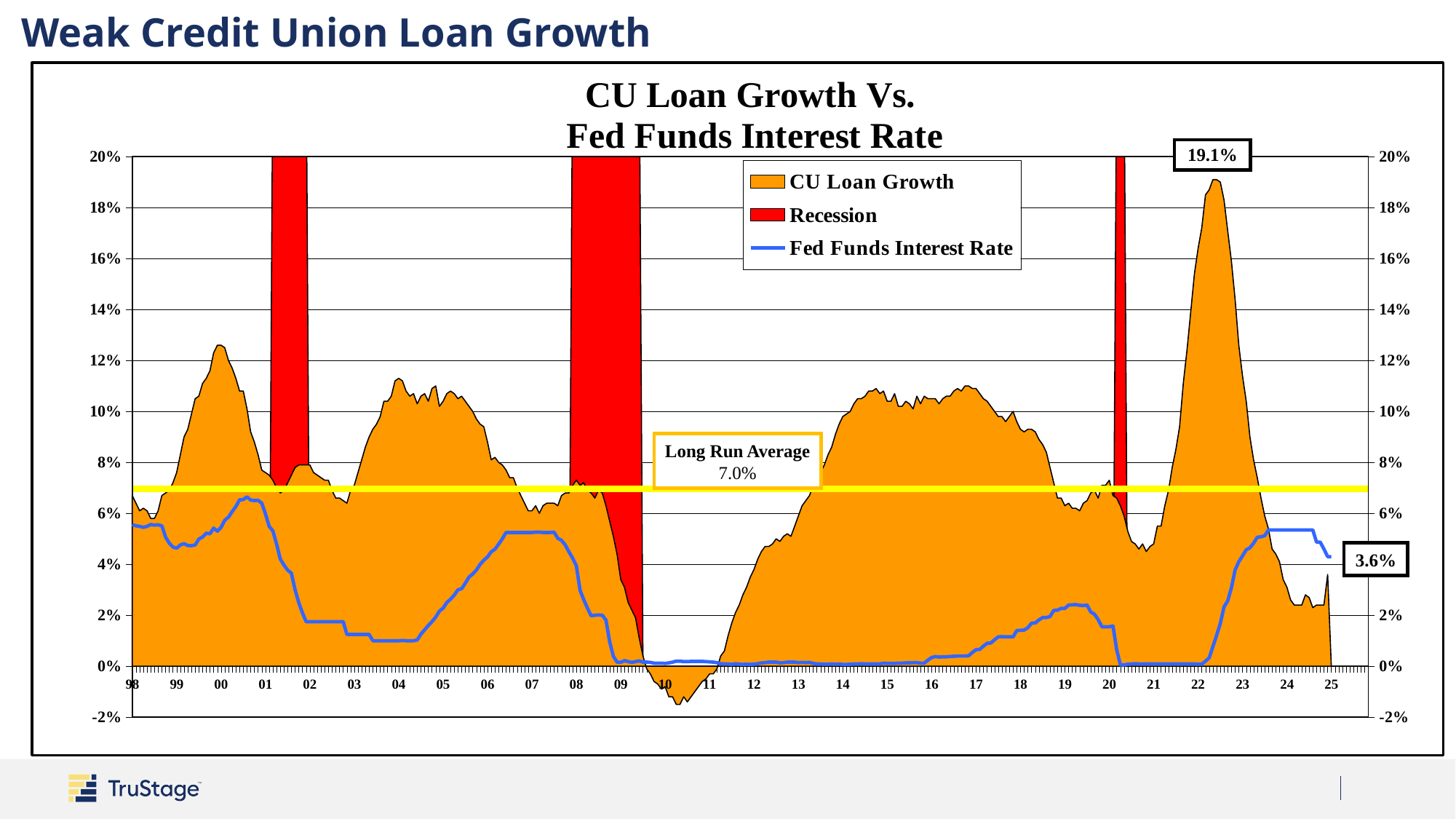
What is the title of the chart? CU Loan Growth Vs. Fed Funds Interest Rate Is the Fed Funds Interest Rate in 2024 greater or less than 4%? greater What is the difference between the labeled peak CU Loan Growth of 19.1% and the latest labeled value of 3.6%? 15.5 percentage points What is the Long Run Average value shown on the chart? 7.0% Is the latest labeled CU Loan Growth value (3.6%) higher or lower than the Long Run Average (7.0%)? lower Does CU Loan Growth rise or fall from its 2022 peak to 2025? fall How many series does the chart legend list? 3 What is the peak CU Loan Growth value labeled on the chart? 19.1% What is the most recent CU Loan Growth value labeled at the right end of the chart? 3.6% Is the Fed Funds Interest Rate in 2012 greater or less than 2%? less Is the CU Loan Growth value around 2010 greater or less than 0%? less In which year does CU Loan Growth reach its highest point on the chart? 2022